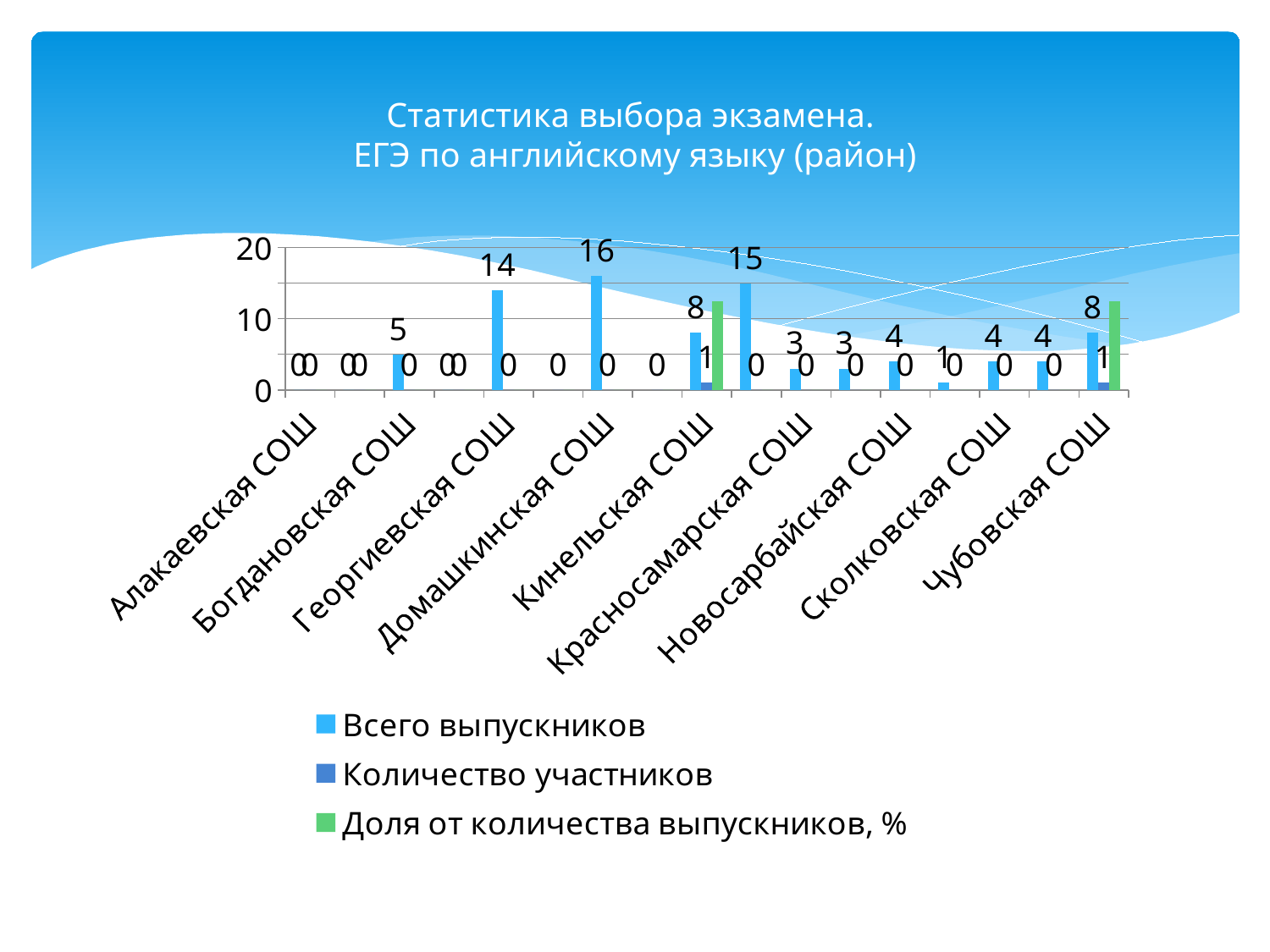
Which labelled school has the highest value of 'Всего выпускников'? Домашкинская СОШ What is the value of 'Всего выпускников' for Георгиевская СОШ? 14 What is the value of 'Всего выпускников' for Богдановская СОШ? 5 Is the value of 'Доля от количества выпускников, %' for Кинельская СОШ greater or less than 10? greater What is the difference in 'Всего выпускников' between Домашкинская СОШ and Георгиевская СОШ? 2 Which has a larger value of 'Всего выпускников': Богдановская СОШ or Красносамарская СОШ? Богдановская СОШ What kind of chart is shown on the slide? bar chart What is the value of 'Количество участников' for Чубовская СОШ? 1 What is the value of 'Количество участников' for Кинельская СОШ? 1 How many series does the legend list? 3 What is the value of 'Всего выпускников' for Домашкинская СОШ? 16 What is the title of the chart? Статистика выбора экзамена. ЕГЭ по английскому языку (район)